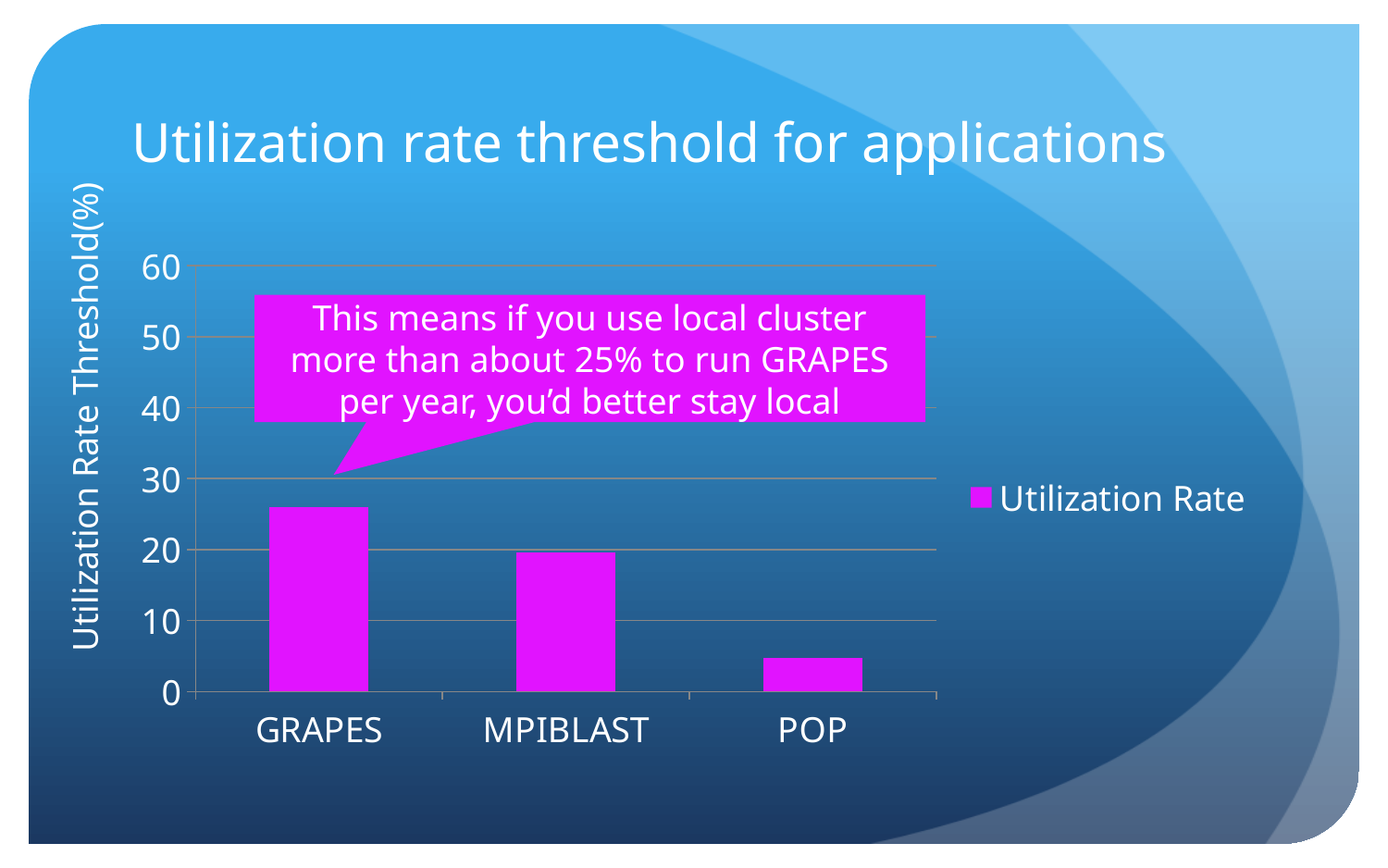
What kind of chart is shown on the slide? bar chart Is the value for GRAPES greater or less than 30? less Which has a larger utilization rate threshold, GRAPES or MPIBLAST? GRAPES Is the value for GRAPES greater or less than 20? greater Do the bar values rise or fall from left to right across the x axis? fall Which application has the highest utilization rate threshold? GRAPES How many applications (categories) are shown on the x axis? 3 What is the title of the chart? Utilization rate threshold for applications Is the value for POP greater or less than 10? less Which application has the lowest utilization rate threshold? POP How many series does the legend list? 1